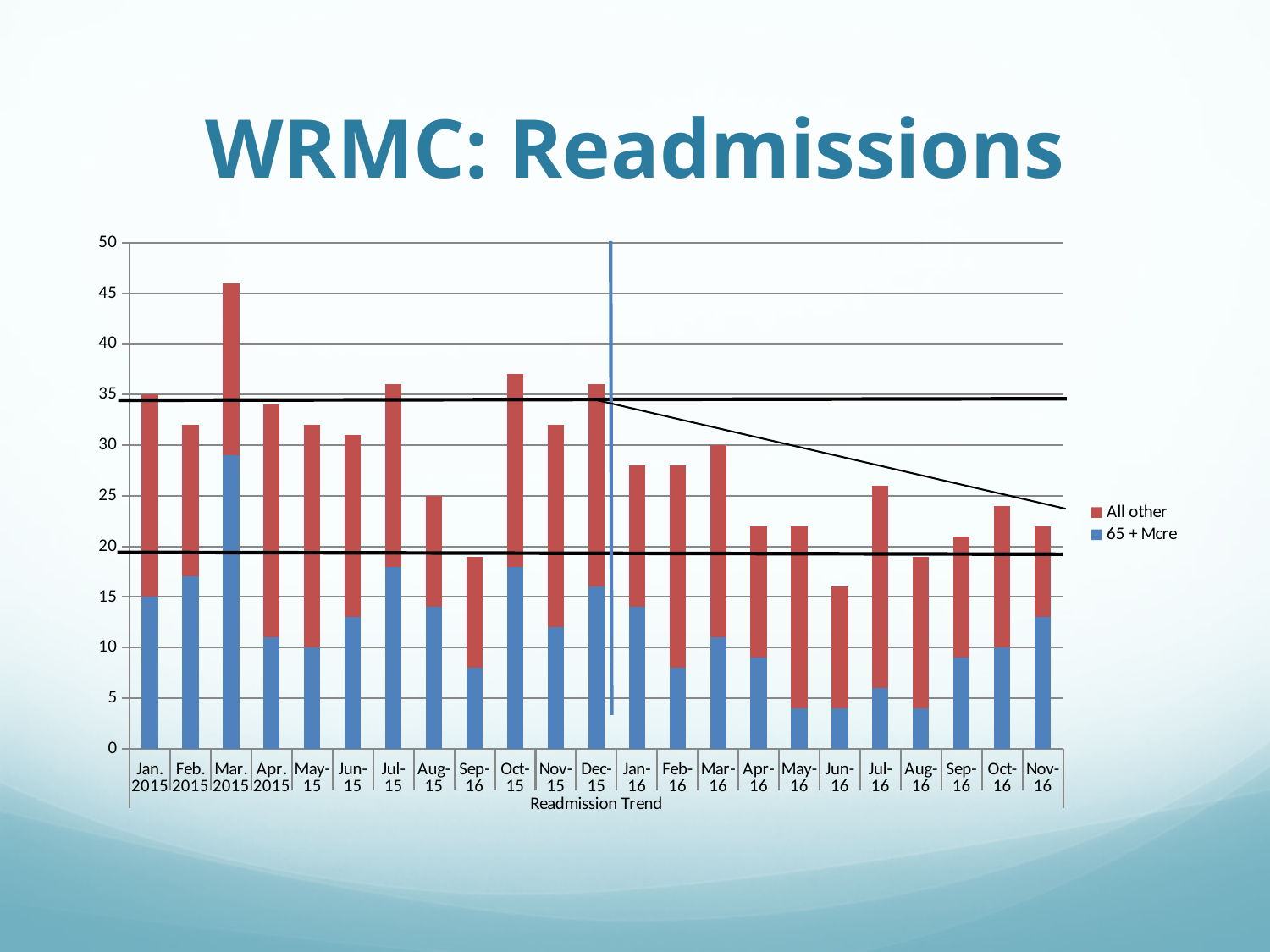
How many months (categories) are plotted along the x axis? 23 Which has the larger total, Jul-15 or Aug-15? Jul-15 Is the total for Mar. 2015 greater or less than 40? greater Is the total for Jun-16 greater or less than 20? less How many series does the legend list? 2 What is the x-axis title of the chart? Readmission Trend Do total readmissions generally rise or fall from 2015 to 2016? fall Is the total for Oct-15 greater or less than 30? greater Which month has the lowest total readmissions? Jun-16 Which month has the largest 65 + Mcre segment? Mar. 2015 What kind of chart is shown on the slide? Stacked bar chart Which month has the highest total readmissions? Mar. 2015